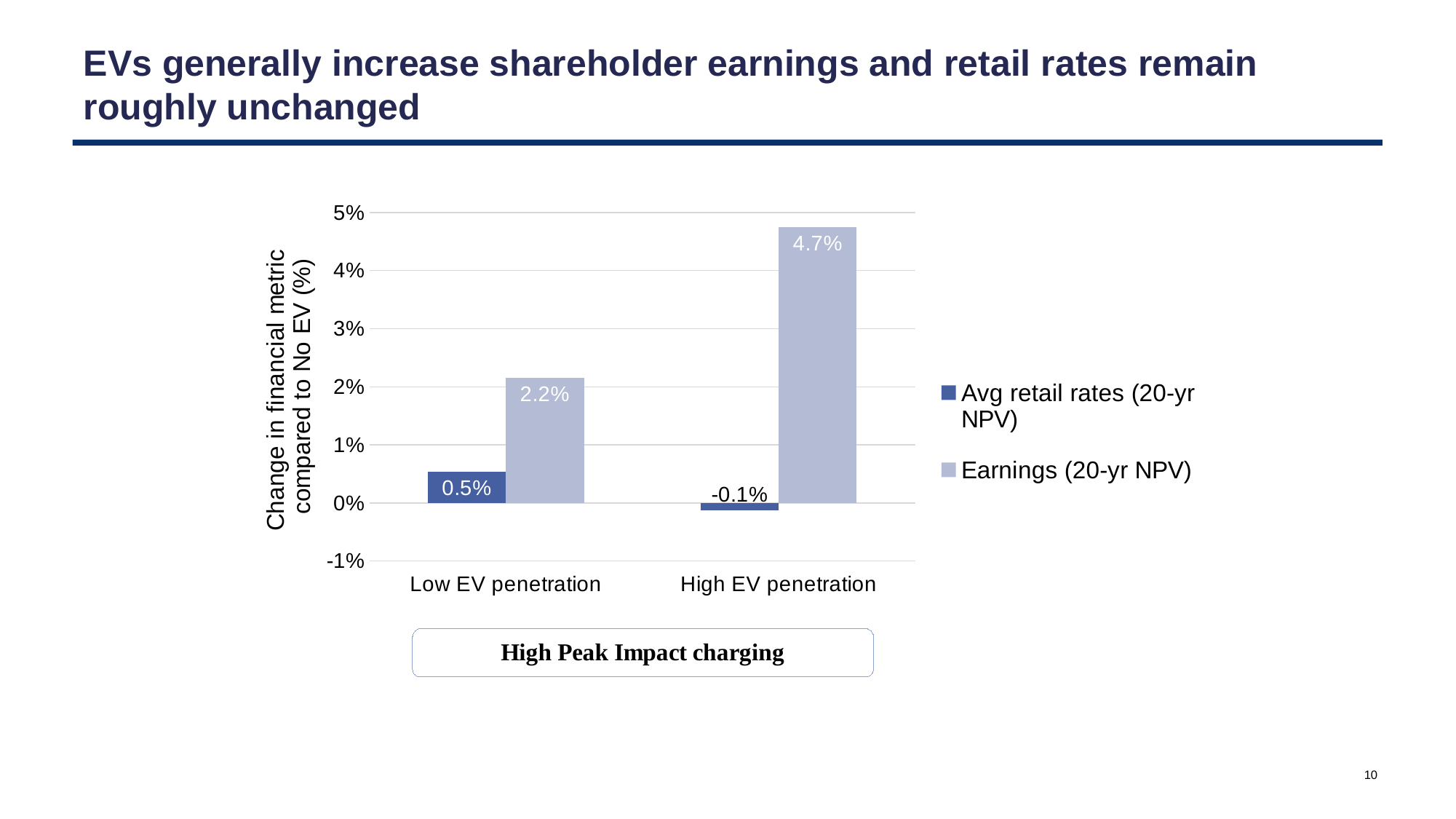
Which category has the highest Earnings (20-yr NPV) value? High EV penetration What kind of chart is shown on the slide? Bar chart How many categories are shown on the x axis? 2 What is the value for Avg retail rates (20-yr NPV) under Low EV penetration? 0.5% Is the Earnings (20-yr NPV) value for High EV penetration greater or less than 4%? greater How many series does the legend list? 2 Which is larger under Low EV penetration: Avg retail rates (20-yr NPV) or Earnings (20-yr NPV)? Earnings (20-yr NPV) What is the value for Avg retail rates (20-yr NPV) under High EV penetration? -0.1% What is the value for Earnings (20-yr NPV) under Low EV penetration? 2.2% What is the value for Earnings (20-yr NPV) under High EV penetration? 4.7% Which category has the lowest Avg retail rates (20-yr NPV) value? High EV penetration What is the difference between the Earnings (20-yr NPV) values for High EV penetration and Low EV penetration? 2.5%